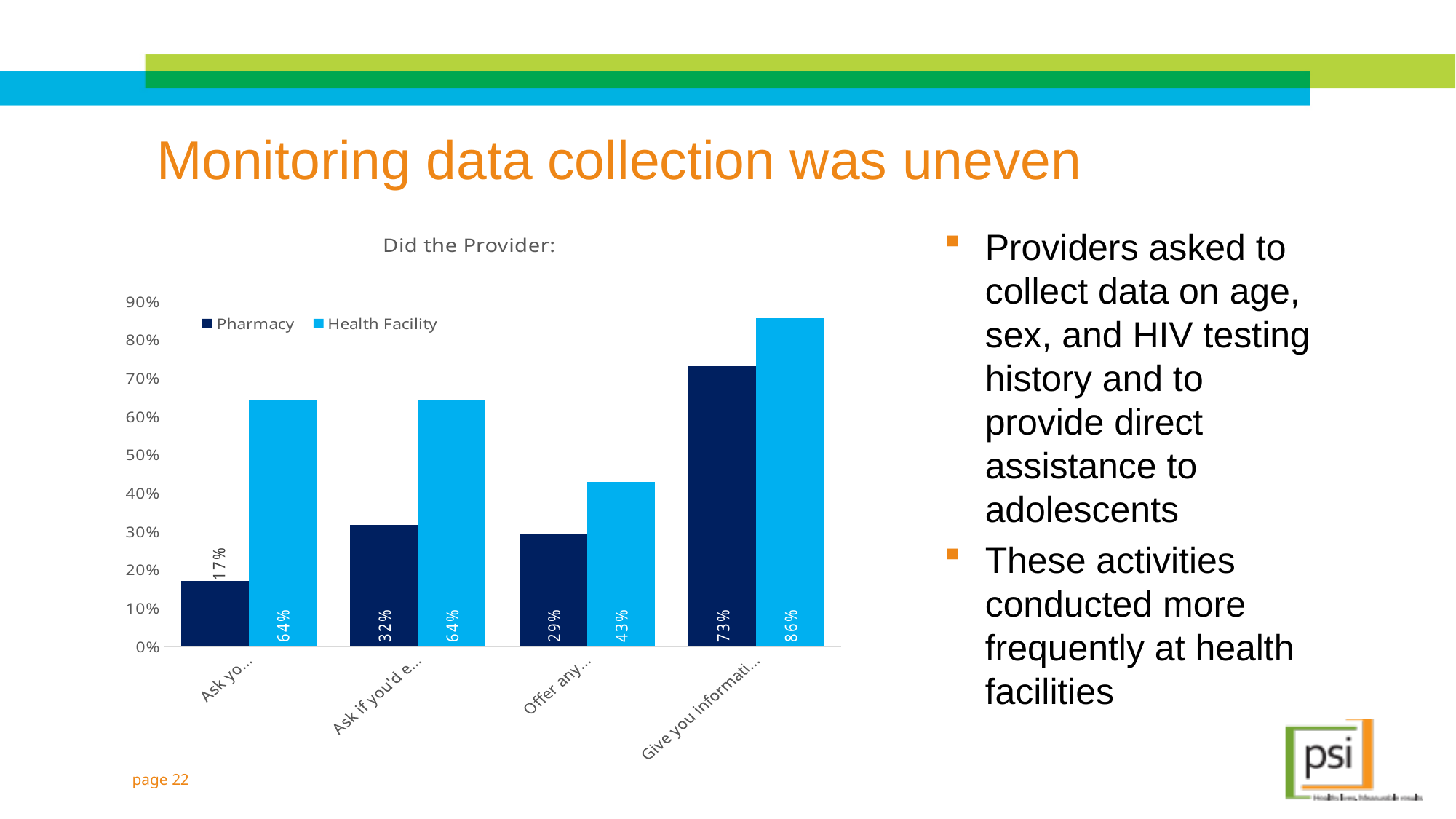
What kind of chart is shown on the slide? bar chart What is the Health Facility value for the third category ("Offer any...")? 43% What is the title of the chart? Did the Provider: Which series is shown in dark blue in the chart? Pharmacy How many series does the chart legend list? 2 For the second category ("Ask if you'd e..."), which is larger: the Pharmacy value or the Health Facility value? Health Facility What is the Health Facility value for the fourth category ("Give you informati...")? 86% Which category has the highest Pharmacy value? Give you informati... Which category has the lowest Pharmacy value? Ask yo... What is the Pharmacy value for the first category ("Ask yo...")? 17% What is the difference between the Health Facility and Pharmacy values for the first category ("Ask yo...")? 47% How many categories are shown along the x axis of the chart? 4